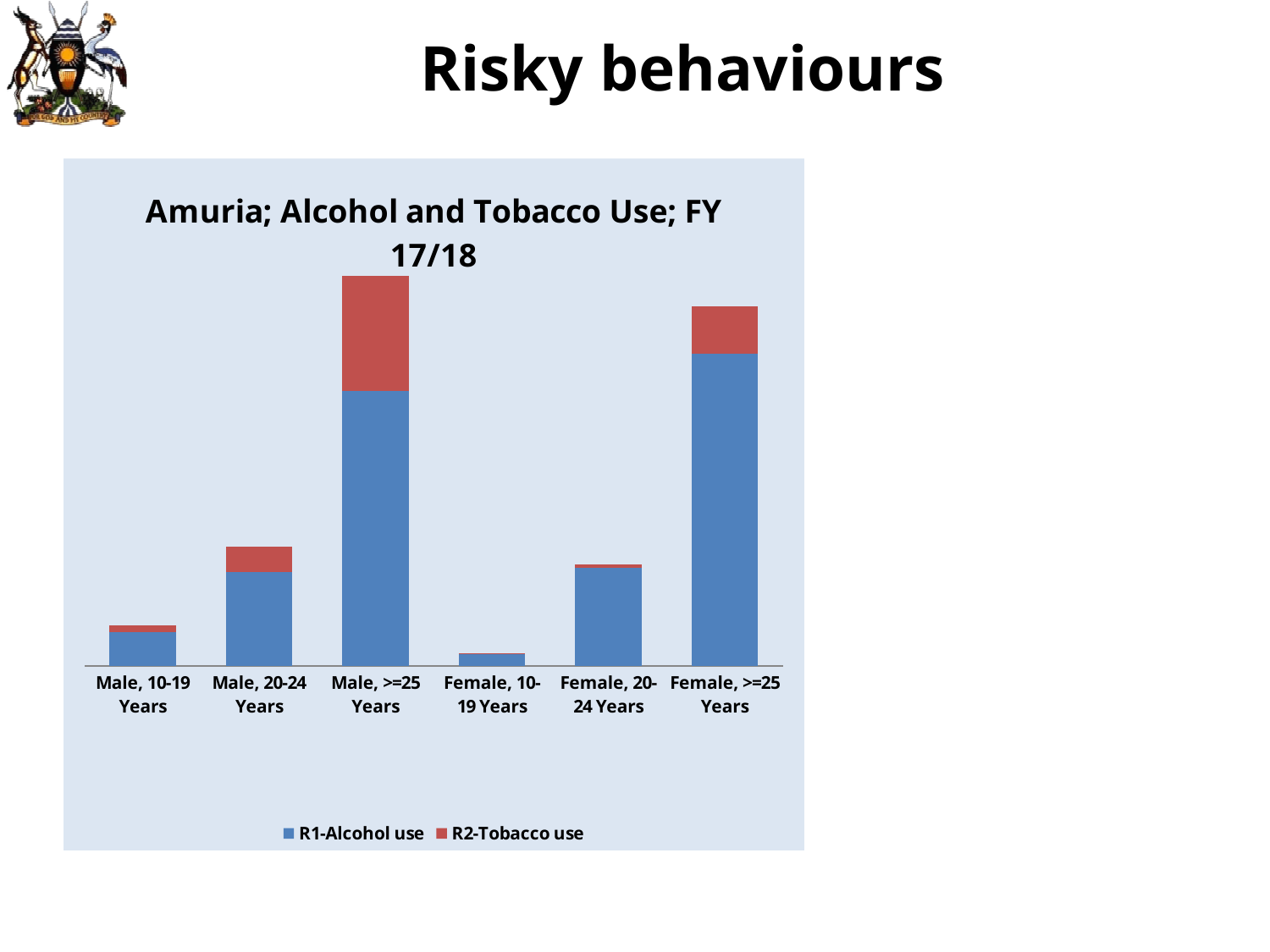
How many categories are shown on the x axis? 6 What kind of chart is shown on the slide? Stacked bar chart Which category has the shortest stacked bar overall? Female, 10-19 Years Which category has the largest R1-Alcohol use segment? Female, >=25 Years Which category has the smallest R1-Alcohol use segment? Female, 10-19 Years What are the two series named in the legend? R1-Alcohol use and R2-Tobacco use What is the title of the chart? Amuria; Alcohol and Tobacco Use; FY 17/18 Which category has the largest R2-Tobacco use segment? Male, >=25 Years Which category has the tallest stacked bar overall? Male, >=25 Years How many series does the legend list? 2 Which has the taller stacked bar, Male, >=25 Years or Female, >=25 Years? Male, >=25 Years Which has the taller stacked bar, Male, 10-19 Years or Female, 10-19 Years? Male, 10-19 Years